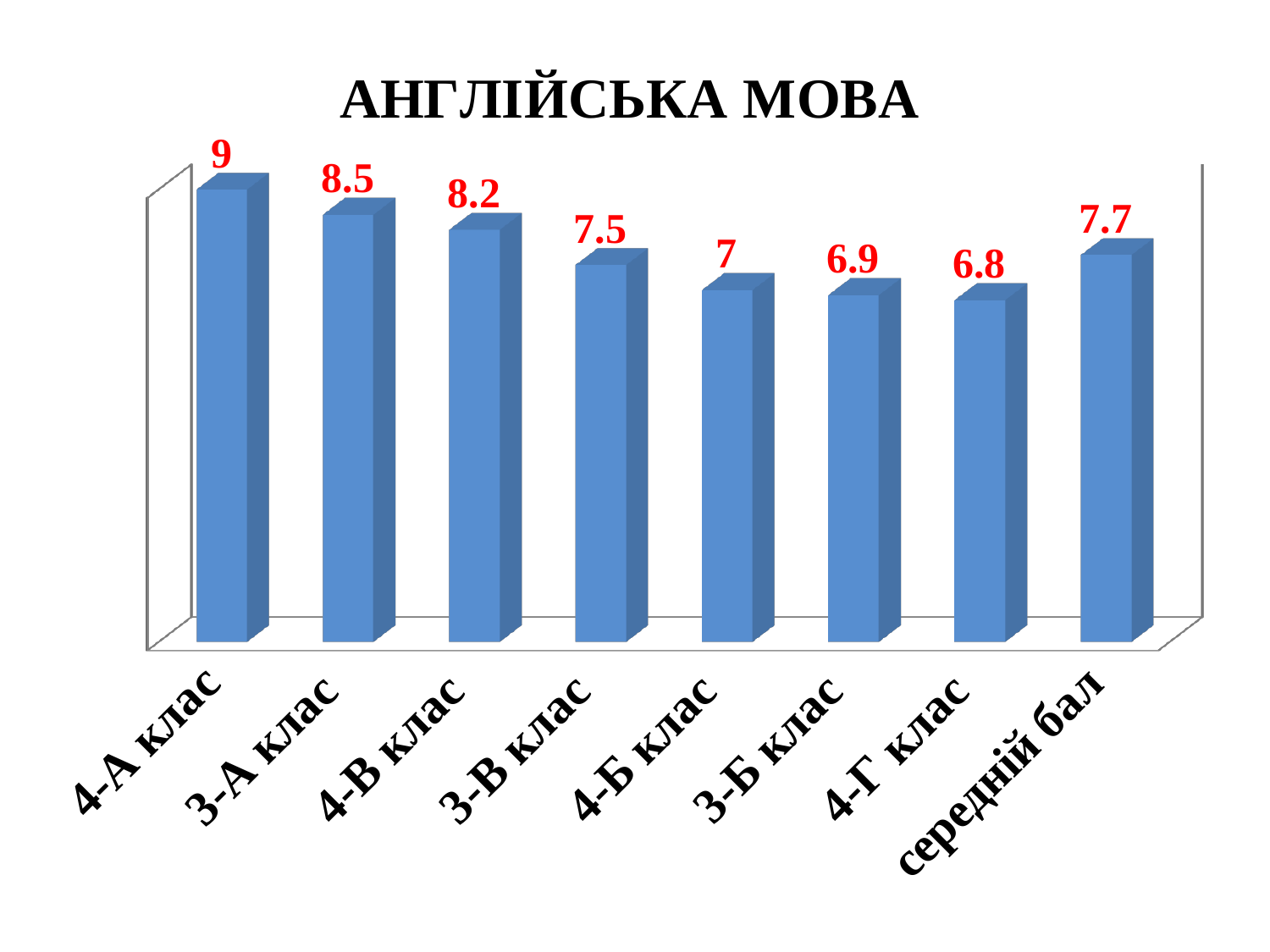
Which is larger, the value for 3-А клас or the value for 4-В клас? 3-А клас How many categories are shown on the chart? 8 What is the value for 3-В клас? 7.5 What is the title of the chart? АНГЛІЙСЬКА МОВА What is the difference between the values for 4-В клас and 4-Б клас? 1.2 What is the difference between the values for 4-А клас and 3-А клас? 0.5 What is the value for 4-А клас? 9 Which category has the highest value? 4-А клас Which category has the lowest value? 4-Г клас What kind of chart is this? bar chart What is the value for 4-Г клас? 6.8 What is the value for середній бал? 7.7